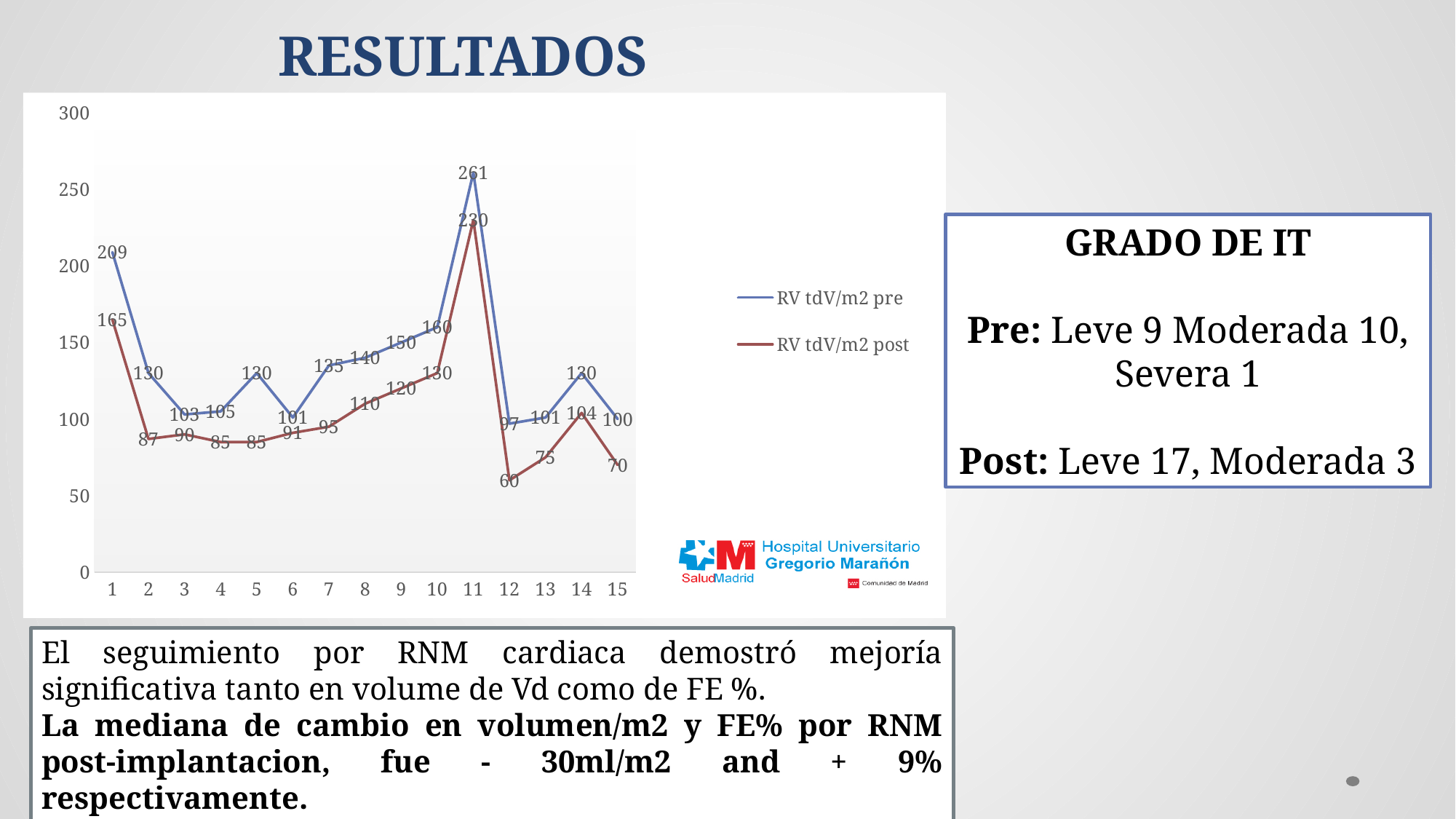
What is the value of RV tdV/m2 post at point 11? 230 At which x-axis point does RV tdV/m2 post reach its lowest value? 12 How many series does the chart legend list? 2 What is the value of RV tdV/m2 pre at point 1? 209 How many points are plotted along the x axis for each series? 15 What kind of chart is shown on the slide? Line chart At which x-axis point does RV tdV/m2 pre reach its highest value? 11 What are the two series names listed in the chart legend? RV tdV/m2 pre and RV tdV/m2 post What is the value of RV tdV/m2 post at point 15? 70 What is the difference between RV tdV/m2 pre and RV tdV/m2 post at point 11? 31 What is the value of RV tdV/m2 pre at point 11? 261 What is the value of RV tdV/m2 post at point 1? 165